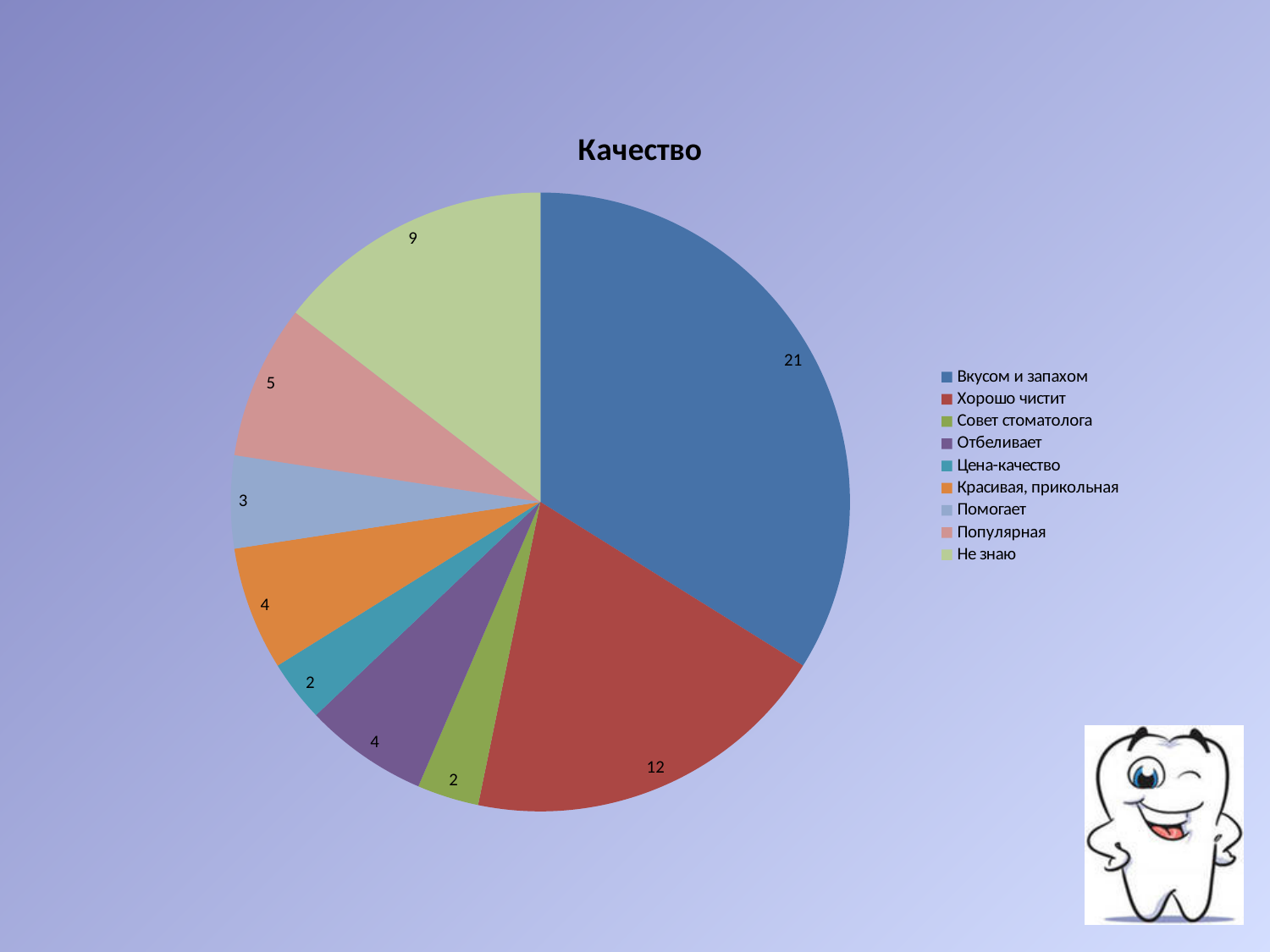
What is the value for Не знаю? 9 What is the value for Популярная? 5 What is the difference between the values for Вкусом и запахом and Хорошо чистит? 9 What is the value for Вкусом и запахом? 21 What is the title of the chart? Качество Which is larger, the value for Не знаю or the value for Популярная? Не знаю What is the total of all the slice values in the pie chart? 62 How many slices does the pie chart have? 9 What is the value for Хорошо чистит? 12 What type of chart is shown on the slide? Pie chart Which category has the largest slice? Вкусом и запахом What is the value for Помогает? 3